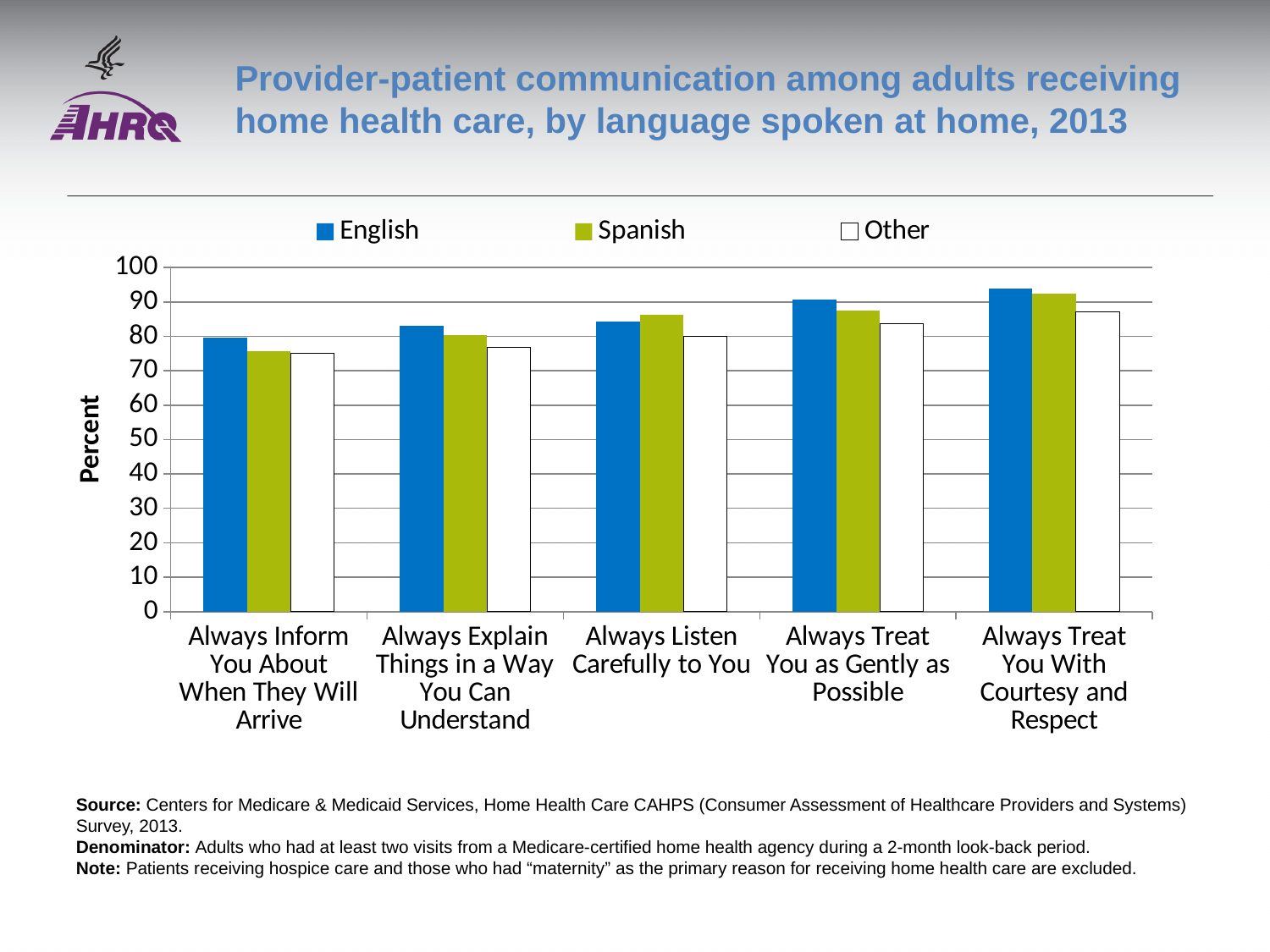
Is the English value for Always Treat You as Gently as Possible greater or less than 80? greater Is the Spanish value for Always Treat You With Courtesy and Respect greater or less than 90? greater For which category is the English value highest? Always Treat You With Courtesy and Respect What is the label on the vertical axis? Percent Is the Other value for Always Inform You About When They Will Arrive greater or less than 80? less What kind of chart is shown on the slide? Bar chart Do the English values rise or fall moving from left to right across the categories? Rise How many categories are shown along the x axis? 5 What colour represents the Spanish series in the legend? Green For which category is the English value lowest? Always Inform You About When They Will Arrive How many series does the legend list? 3 For Always Treat You as Gently as Possible, which is larger, the English value or the Other value? English